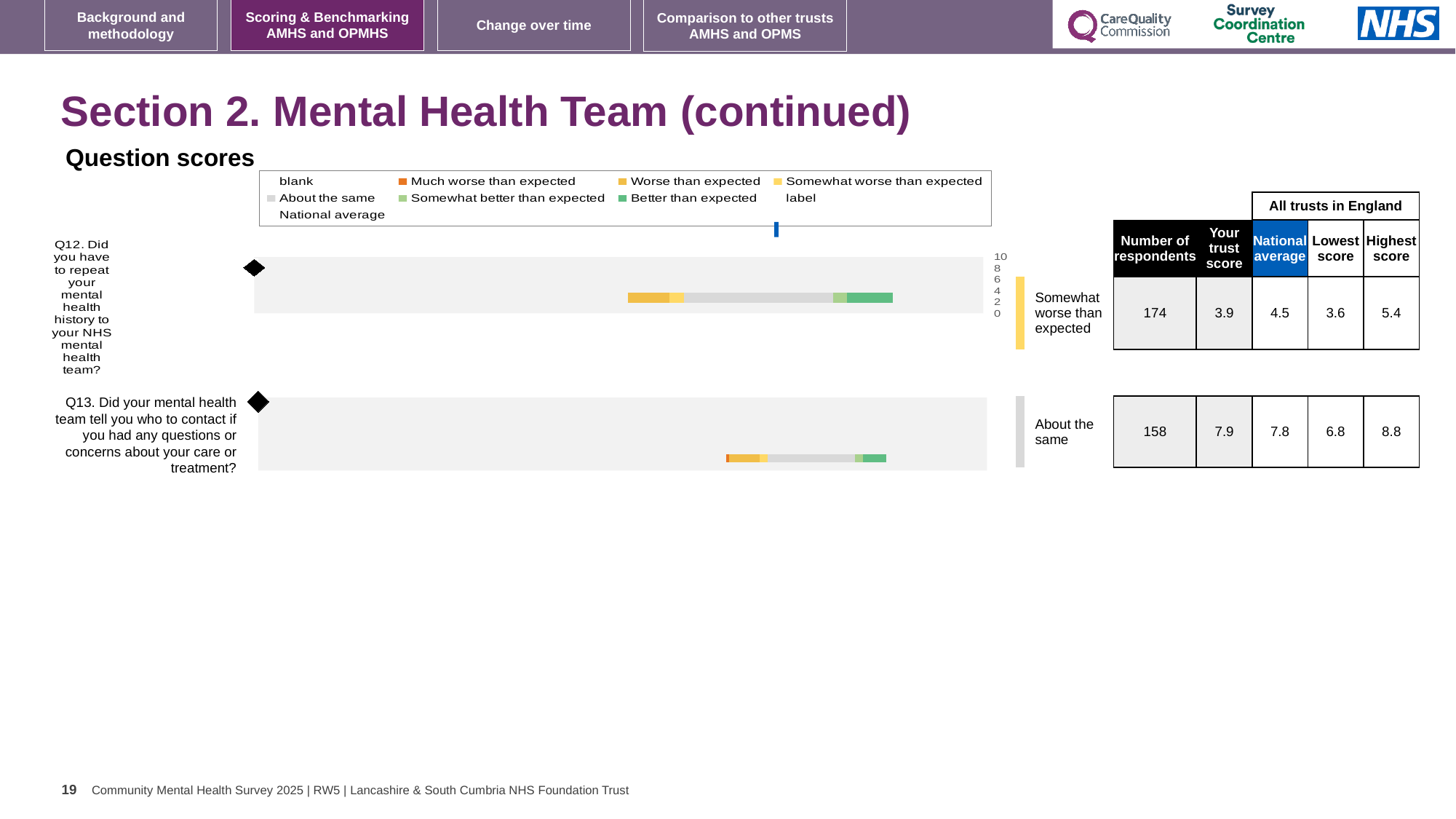
What is the national average for Q13? 7.8 What is the difference between the highest score and the lowest score for Q12? 1.8 For Q13, which is larger: the trust score or the national average? the trust score (7.9) How many entries does the legend of the question scores chart list? 9 What kind of chart is used to show the question scores for Q12 and Q13? bar chart What is the highest score among all trusts in England for Q12? 5.4 Which benchmark category is Q13 assigned to? About the same What is the trust score for Q12? 3.9 Which benchmark category is Q12 assigned to? Somewhat worse than expected What is the number of respondents for Q12? 174 What is the highest tick value shown on the chart's score axis? 10 How many questions are plotted in the question scores chart? 2